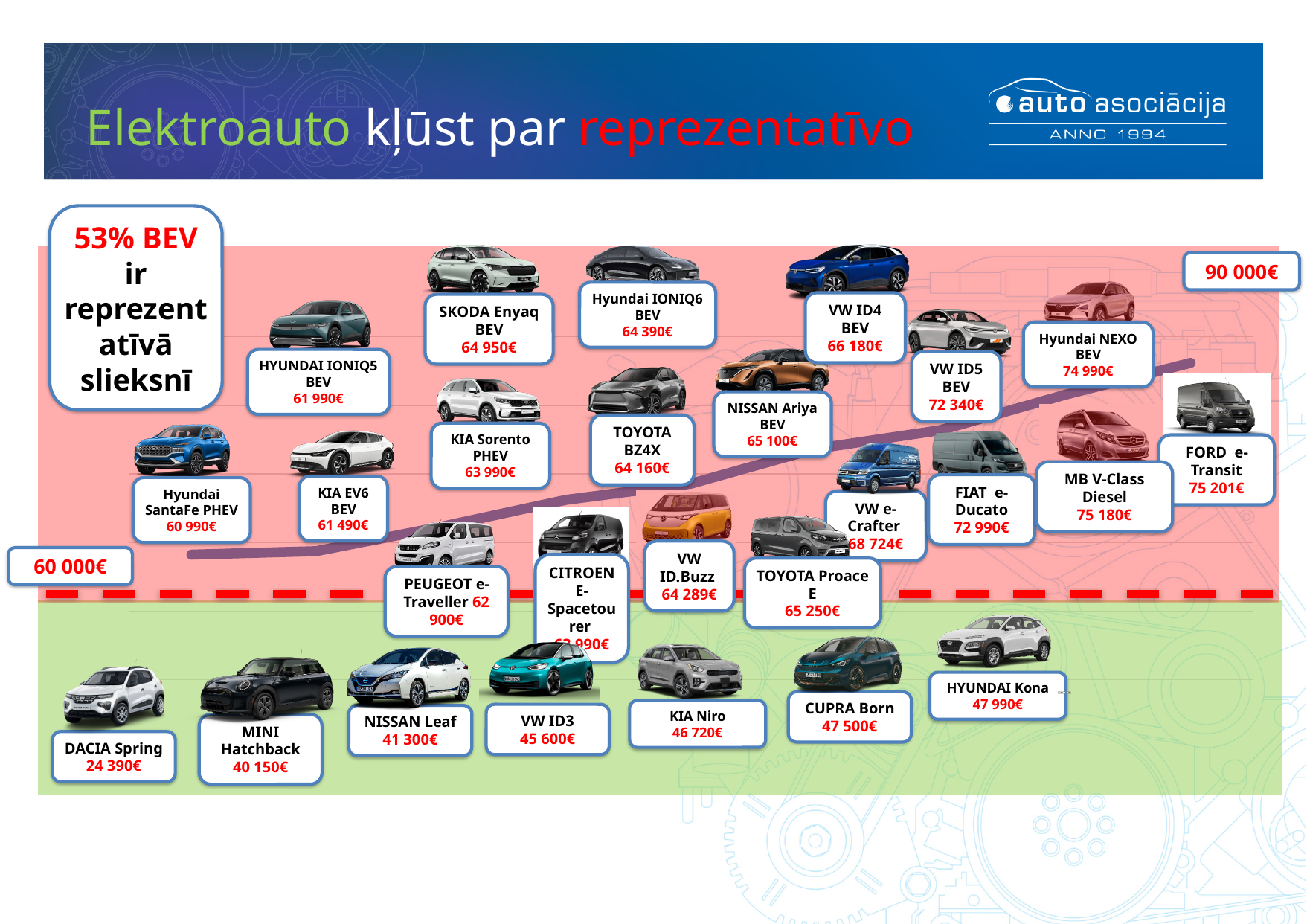
What percentage of BEVs does the callout say are in the representative threshold? 53% What is the price shown for the KIA Niro? 46 720€ Which vehicle has the lowest price shown on the slide? DACIA Spring Is the price of the HYUNDAI Kona greater or less than 60 000€? less What is the price shown for the VW ID4 BEV? 66 180€ What price threshold is marked by the red dashed line? 60 000€ What is the difference in price between the VW ID5 BEV and the VW ID4 BEV? 6 160€ Which is more expensive, the SKODA Enyaq BEV or the Hyundai IONIQ6 BEV? SKODA Enyaq BEV How many vehicles are shown below the 60 000€ dashed line? 7 What is the price shown for the DACIA Spring? 24 390€ What is the price shown for the FORD e-Transit? 75 201€ Which vehicle has the highest price shown on the slide? FORD e-Transit